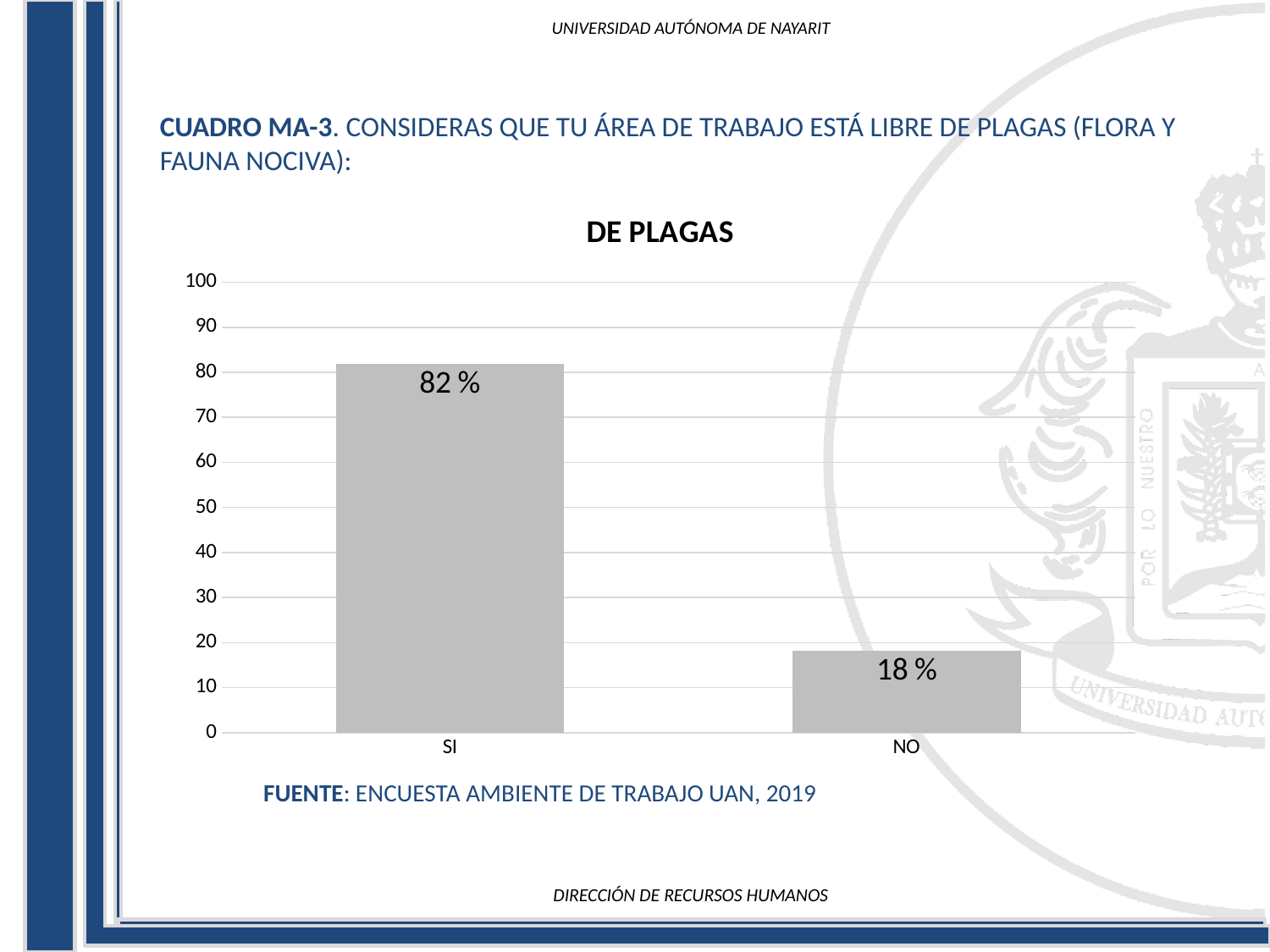
Which is larger, the value for SI or the value for NO? SI Is the value for NO greater or less than 20? less What is the value for SI? 82 % What is the title of the chart? DE PLAGAS What kind of chart is shown? bar chart Which category has the highest value? SI What is the difference between the values for SI and NO? 64 % What is the value for NO? 18 % What is the highest value shown on the y axis? 100 How many categories are shown on the x axis? 2 Is the value for SI greater or less than 50? greater Which category has the lowest value? NO